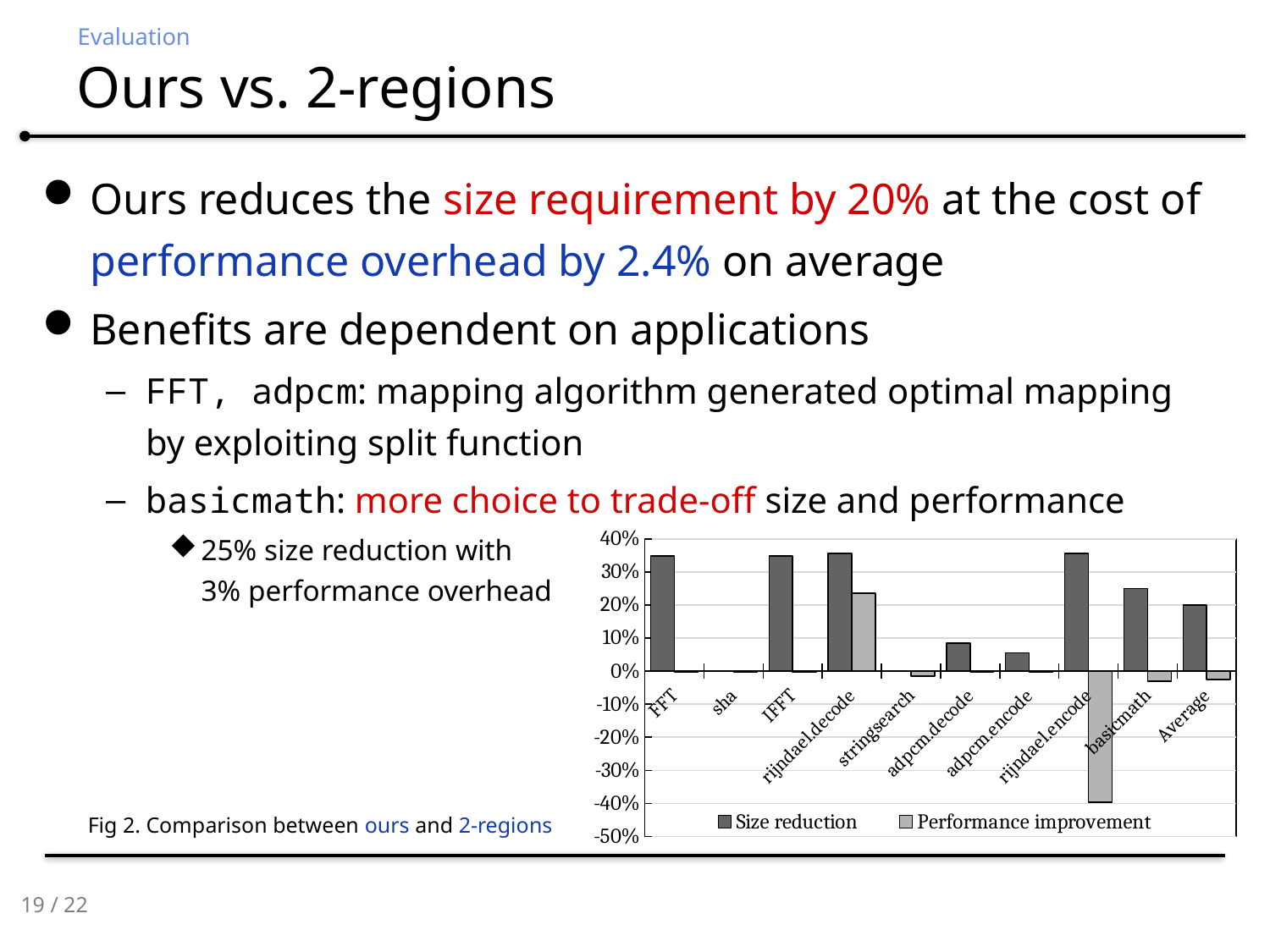
How many categories are shown along the x axis of the chart? 10 Which is larger, the Size reduction for basicmath or the Size reduction for adpcm.encode? basicmath Is the Performance improvement value for rijndael.decode greater or less than 20%? greater Is the Performance improvement value for rijndael.encode greater or less than -30%? less How many series does the chart's legend list? 2 Which category has the lowest Performance improvement value? rijndael.encode Which category has the highest Performance improvement value? rijndael.decode What kind of chart is shown on the slide? bar chart What are the two series named in the chart's legend? Size reduction and Performance improvement Is the Size reduction value for adpcm.decode greater or less than 10%? less What is the caption of the figure containing the chart? Fig 2. Comparison between ours and 2-regions